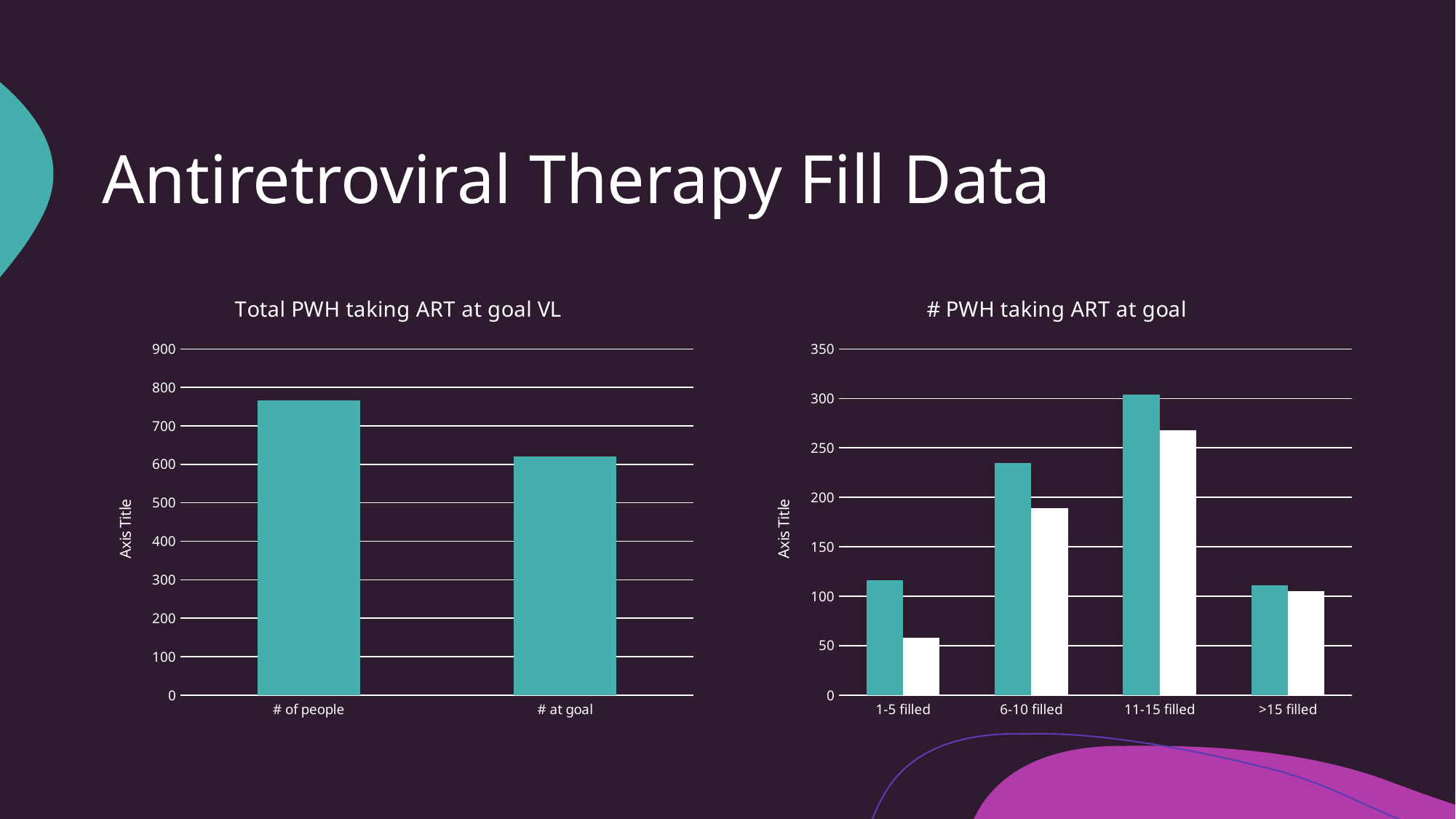
In the chart "# PWH taking ART at goal", which category has the shortest white bar? 1-5 filled In the chart "# PWH taking ART at goal", is the white bar for "1-5 filled" greater or less than 100? less In the chart "# PWH taking ART at goal", how many categories are shown on the x axis? 4 In the chart "Total PWH taking ART at goal VL", which category has the higher bar? # of people In the chart "# PWH taking ART at goal", which is larger: the teal bar for "6-10 filled" or the teal bar for ">15 filled"? 6-10 filled In the chart "Total PWH taking ART at goal VL", is the value for "# of people" greater or less than 700? greater What is the title of the right-hand chart on the slide? # PWH taking ART at goal What type of chart is the left chart titled "Total PWH taking ART at goal VL"? bar chart In the chart "Total PWH taking ART at goal VL", is the value for "# at goal" greater or less than 700? less In the chart "Total PWH taking ART at goal VL", how many categories are shown on the x axis? 2 In the chart "# PWH taking ART at goal", which category has the tallest teal bar? 11-15 filled